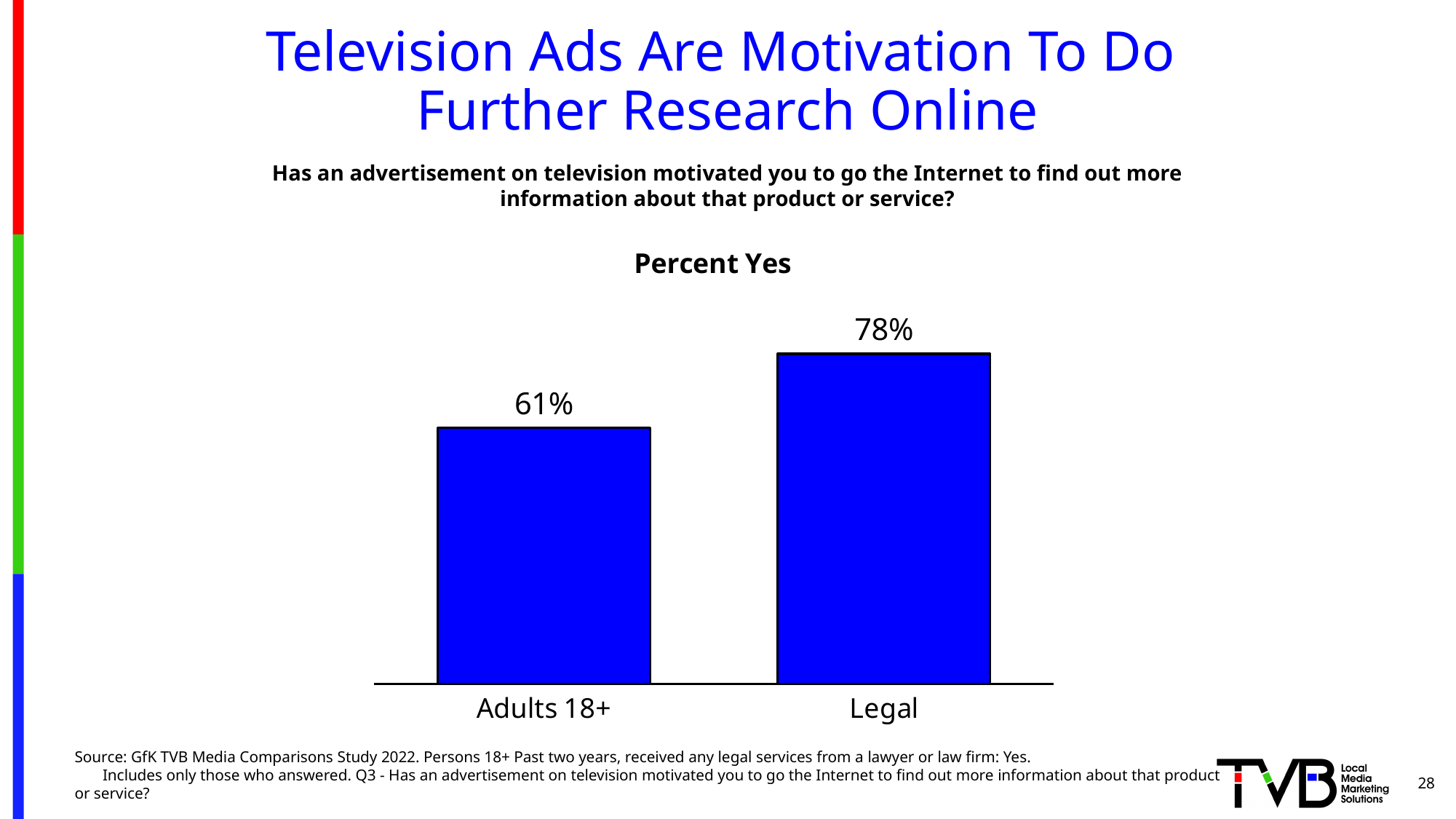
What colour are the bars in the chart? Blue What is the title of the chart? Percent Yes What kind of chart is shown on the slide? Bar chart How many categories are shown in the chart? 2 What is the difference in percentage points between Legal and Adults 18+? 17 percentage points Which is larger, the value for Legal or the value for Adults 18+? Legal What is the Percent Yes value for Adults 18+? 61% What is the Percent Yes value for Legal? 78% Which category has the highest Percent Yes value? Legal Which category has the lowest Percent Yes value? Adults 18+